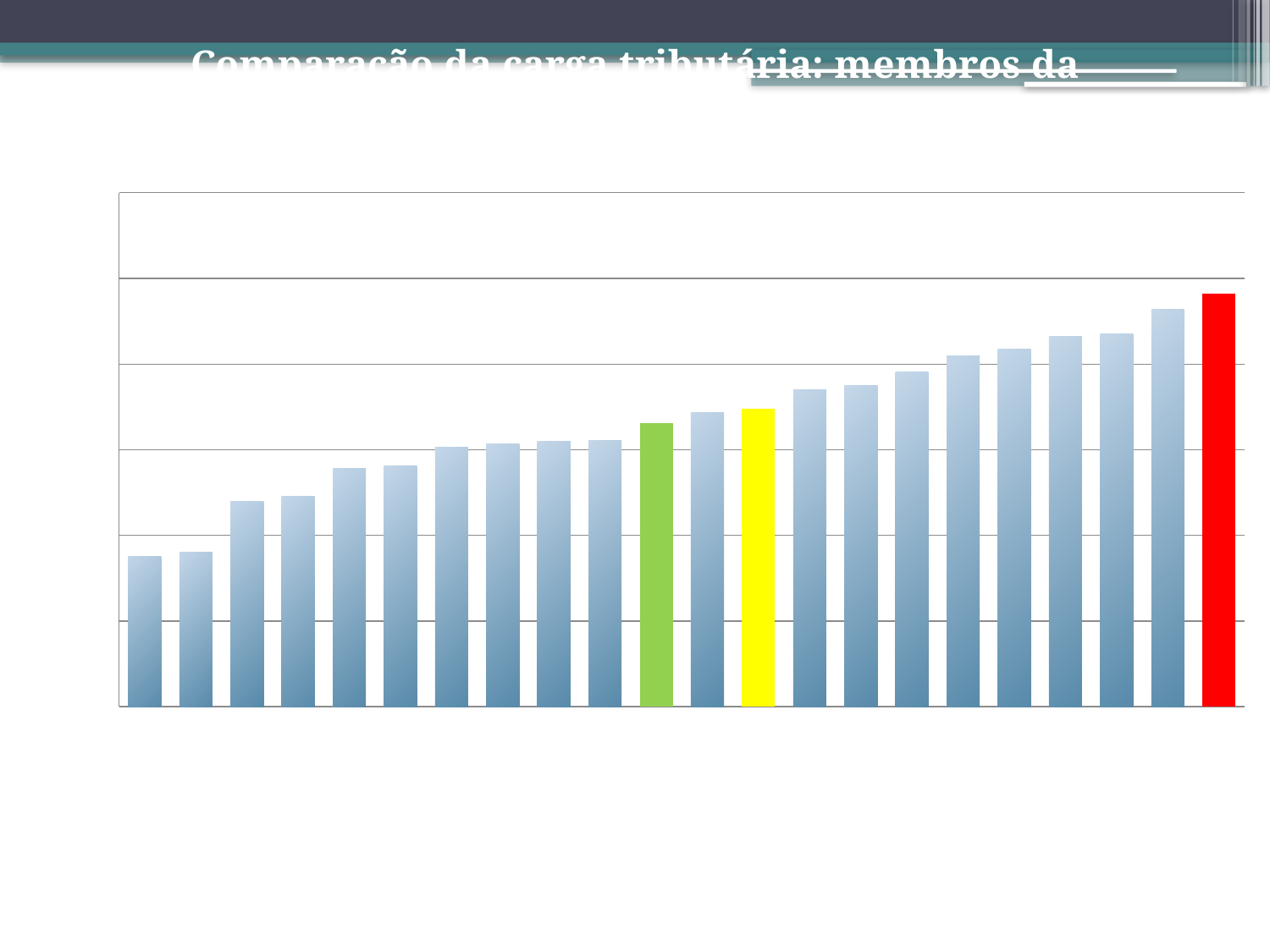
What colour is the rightmost bar in the chart? red Which is taller, the red bar or the green bar? the red bar Do the bar values generally rise or fall from left to right across the chart? rise How many bars are plotted in the chart? 22 Which bar is the tallest in the chart? the red bar (rightmost) Which is taller, the leftmost bar or the rightmost bar? the rightmost bar Apart from the blue bars, what colours are used to highlight individual bars in the chart? green, yellow and red Which is taller, the yellow bar or the green bar? the yellow bar What kind of chart is shown on the slide? bar chart